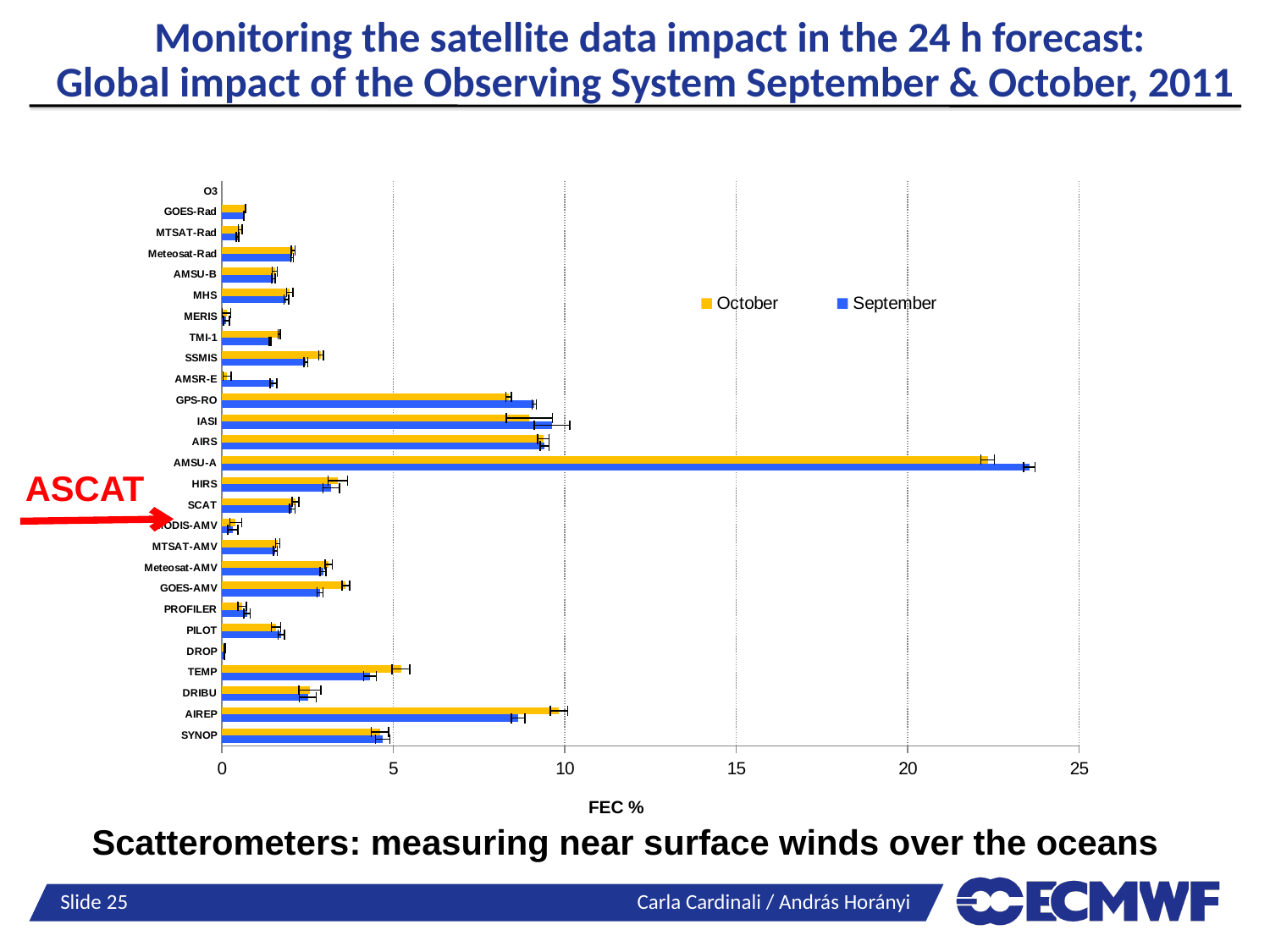
What is the label of the horizontal axis? FEC % How many series does the legend list? 2 Which category has the highest FEC % value? AMSU-A Which two series are shown in the legend? October and September For AMSU-A, which series has the larger value, October or September? September What kind of chart is shown on the slide? bar chart Is the September value for AMSU-A greater or less than 20? greater For AIREP, which series has the larger value, October or September? October Is the October value for SYNOP greater or less than 5? less Is the October value for Meteosat-AMV greater or less than 5? less How many categories are plotted on the vertical axis? 27